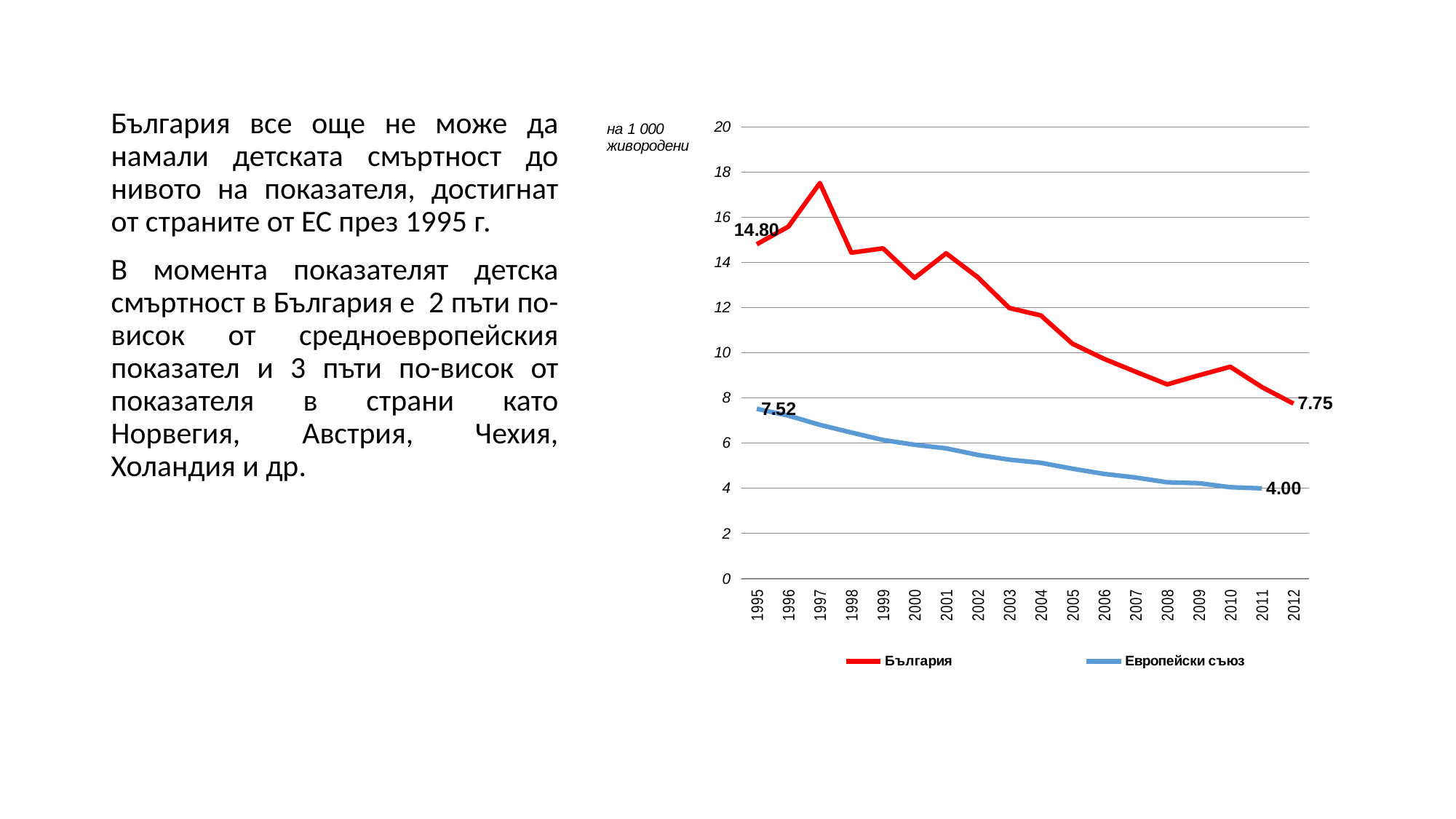
Which is larger: the България value in 2012 or the Европейски съюз value in 1995? България in 2012 What is the value for Европейски съюз in 1995? 7.52 What kind of chart is shown on the slide? line chart What is the value for Европейски съюз in 2011? 4.00 By how much did the value for България fall from 1995 to 2012? 7.05 How many series does the legend list? 2 Is the value for България in 2008 greater or less than 10? less What is the value for България in 1995? 14.80 What is the value for България in 2012? 7.75 In which year does the България line reach its highest point? 1997 Is the value for България in 1997 greater or less than 16? greater What is the difference between the България and Европейски съюз values in 1995? 7.28